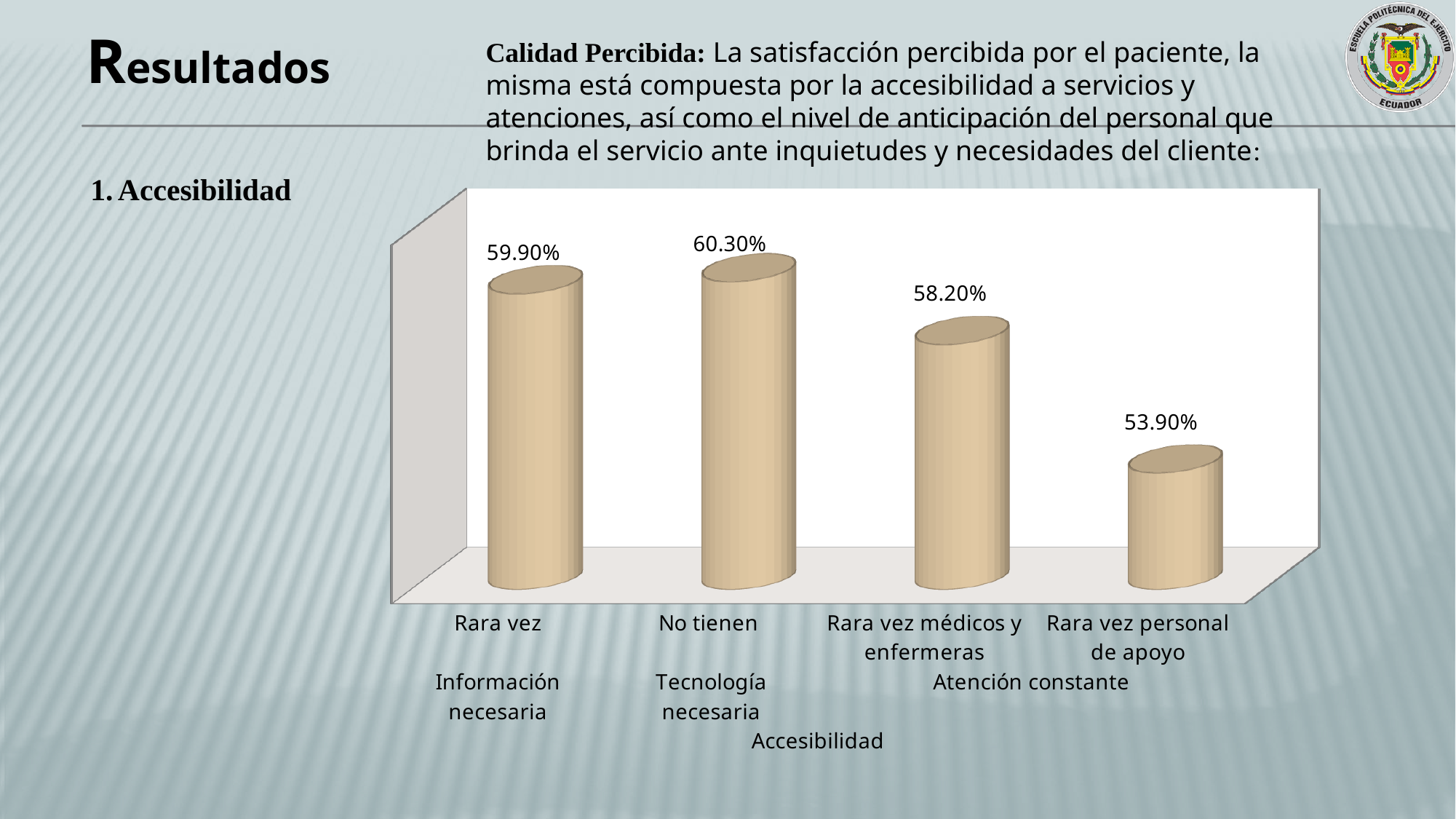
What is the value shown for the 'Rara vez personal de apoyo' bar? 53.90% What is the difference between the 'Rara vez' (Información necesaria) value and the 'Rara vez médicos y enfermeras' value? 1.70% What is the value shown for the 'Rara vez médicos y enfermeras' bar? 58.20% Which is larger: the value for 'Rara vez médicos y enfermeras' or the value for 'Rara vez personal de apoyo'? Rara vez médicos y enfermeras What is the title shown below the category axis of the chart? Accesibilidad What is the value shown for the 'Rara vez' (Información necesaria) bar? 59.90% How many bars are plotted in the chart? 4 Which category has the highest value in the chart? No tienen (Tecnología necesaria) What kind of chart is shown on the slide? Bar chart What is the difference between the 'No tienen' value and the 'Rara vez personal de apoyo' value? 6.40% Which category has the lowest value in the chart? Rara vez personal de apoyo What is the value shown for the 'No tienen' (Tecnología necesaria) bar? 60.30%